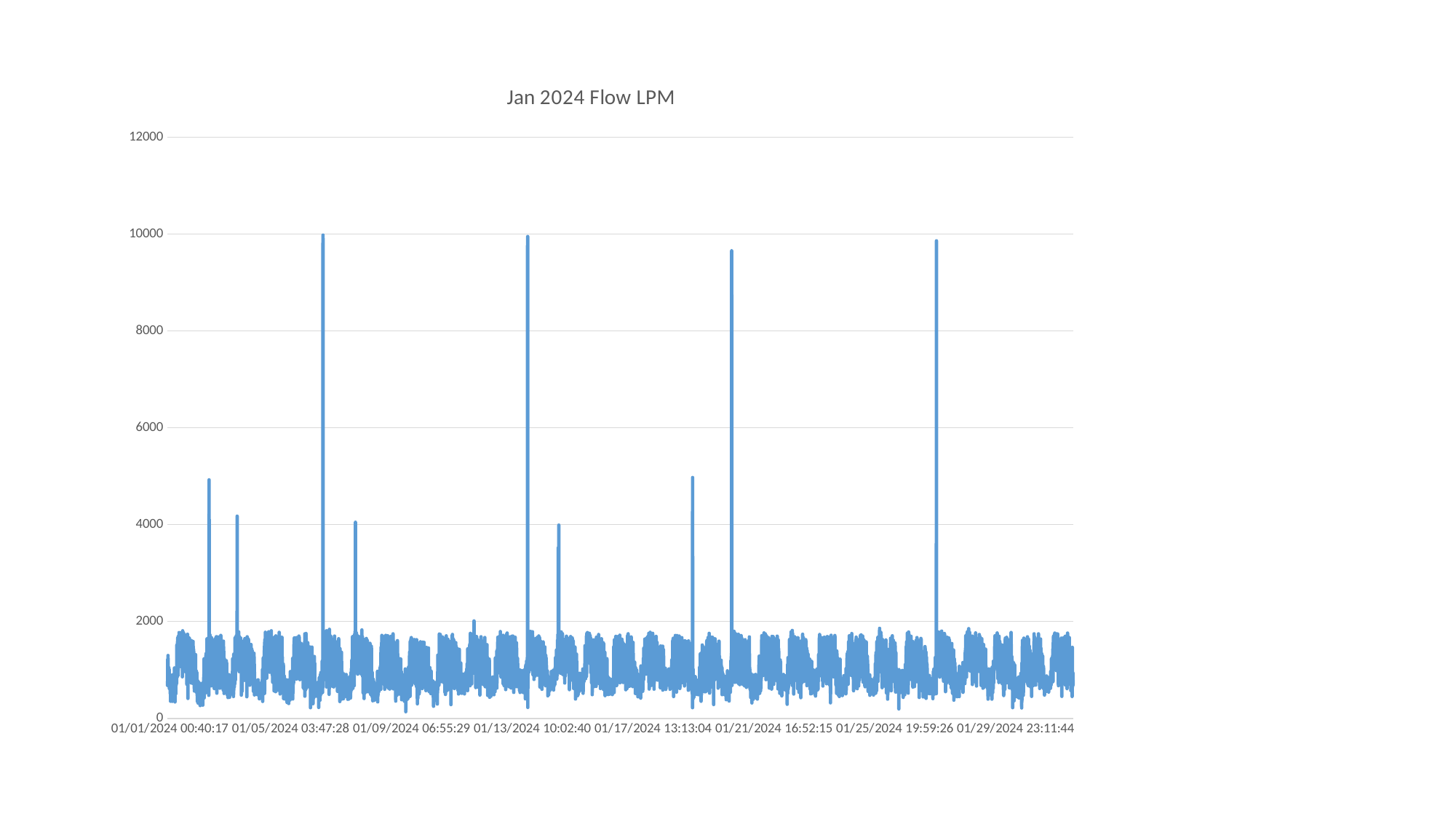
Is the highest spike in the chart greater or less than 8000? greater What is the title of the chart? Jan 2024 Flow LPM Ignoring the spikes, does the baseline of the line rise, fall, or stay roughly flat across January? roughly flat What is the last date label on the horizontal axis? 01/29/2024 23:11:44 What is the highest value shown on the vertical axis? 12000 How many date labels are shown along the horizontal axis? 8 What kind of chart is shown on the slide? line chart What is the first date label on the horizontal axis? 01/01/2024 00:40:17 Is the spike near 01/05/2024 greater or less than 6000? greater Does the line ever reach a value greater than 12000? no How many spikes rise above 8000? 4